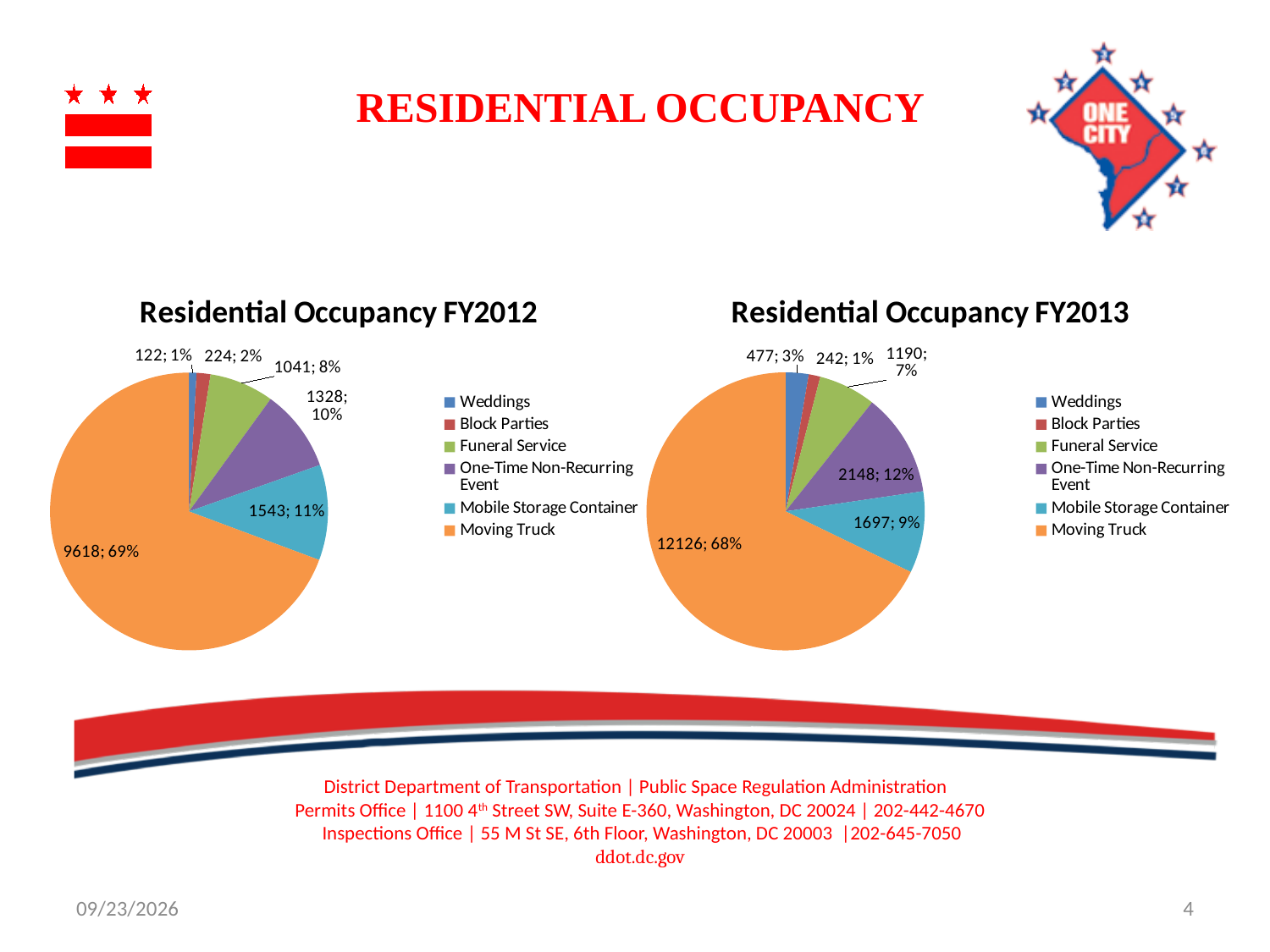
In the Residential Occupancy FY2012 chart, which category has the smallest slice? Weddings What share of the Residential Occupancy FY2012 pie does Mobile Storage Container represent? 11% In the Residential Occupancy FY2013 chart, what value is shown for Weddings? 477; 3% In the Residential Occupancy FY2013 chart, what value is shown for One-Time Non-Recurring Event? 2148; 12% What share of the Residential Occupancy FY2013 pie does Moving Truck represent? 68% In the Residential Occupancy FY2013 chart, which category has the smallest slice? Block Parties In the Residential Occupancy FY2012 chart, what value is shown for Moving Truck? 9618; 69% What type of chart is the Residential Occupancy FY2012 chart? Pie chart What is the difference between the Moving Truck count in the FY2013 chart and the Moving Truck count in the FY2012 chart? 2508 How many categories does the legend of the Residential Occupancy FY2013 chart list? 6 In the Residential Occupancy FY2012 chart, which category has the largest slice? Moving Truck In the Residential Occupancy FY2012 chart, which is larger: Funeral Service or Mobile Storage Container? Mobile Storage Container